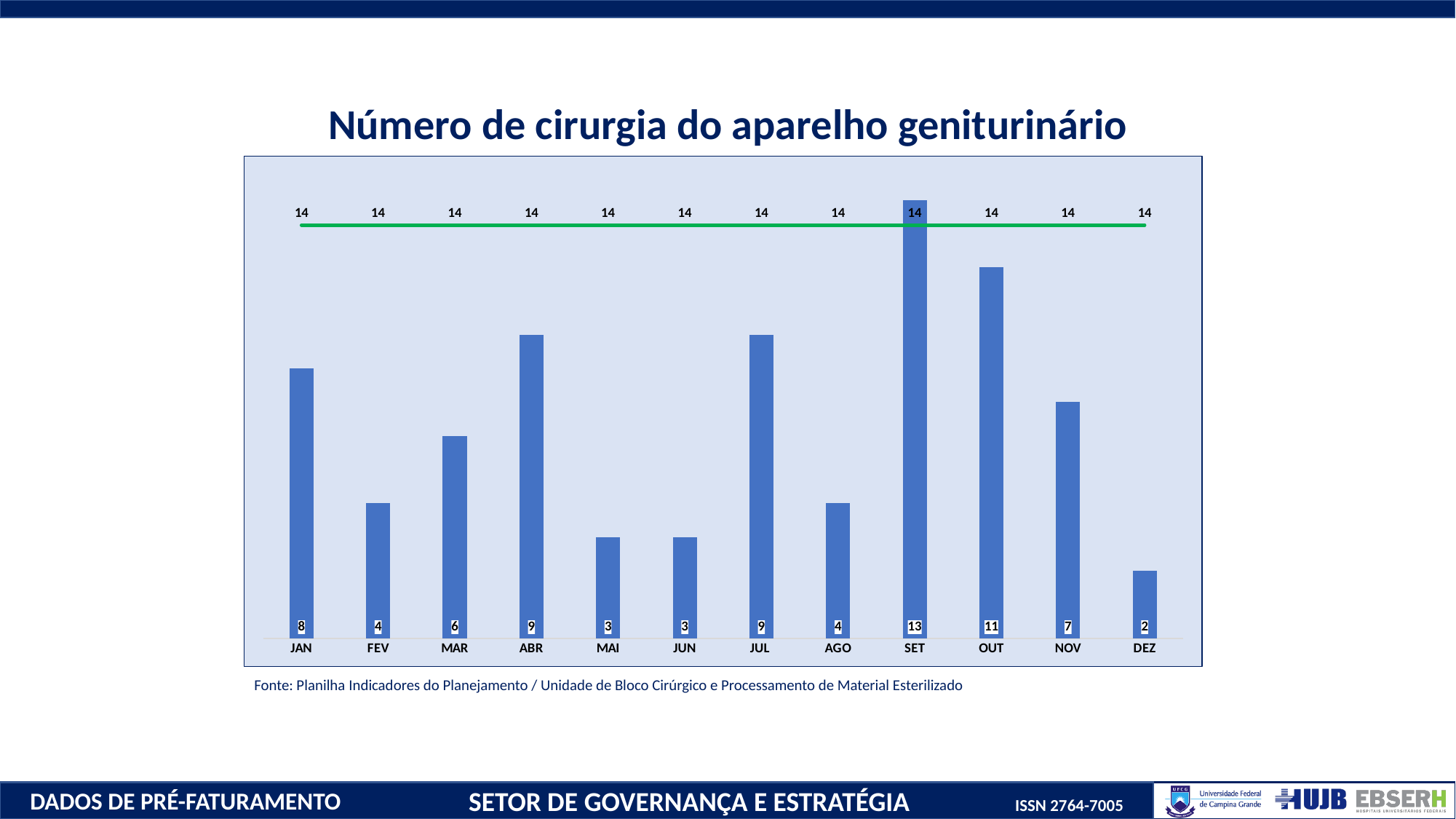
Do the values rise or fall from SET to DEZ? fall What kind of chart is this? bar and line chart What is the difference between the values for OUT and NOV? 4 What is the value for JAN? 8 How many months are shown on the x axis? 12 What is the value for DEZ? 2 What is the title of the chart? Número de cirurgia do aparelho geniturinário What is the value for SET? 13 Which is larger, the value for ABR or the value for MAR? ABR What is the value of the green target line for each month? 14 Which month has the highest number of surgeries? SET Which month has the lowest number of surgeries? DEZ